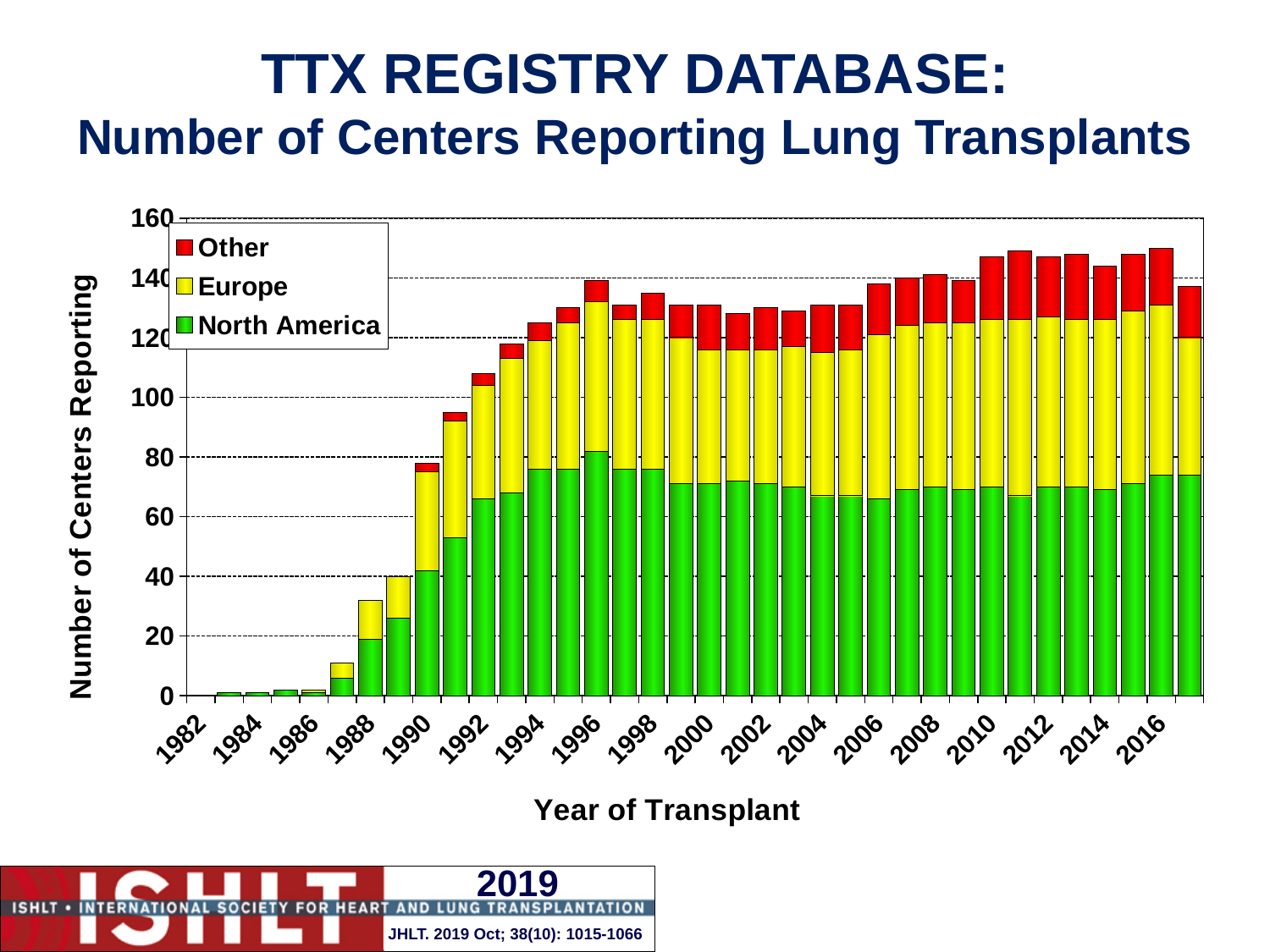
Is the total number of centers reporting in 1988 greater or less than 40? less Is the total number of centers reporting in 2016 greater or less than 140? greater How many series does the legend list? 3 Which three regions are listed in the chart legend? Other, Europe, North America Is the total number of centers reporting in 1996 greater or less than 120? greater Between 1986 and 1996, does the total number of centers reporting rise or fall? rise What is the label of the vertical axis? Number of Centers Reporting Which year has a larger total number of centers reporting, 1990 or 1996? 1996 What kind of chart is shown on the slide? Stacked bar chart